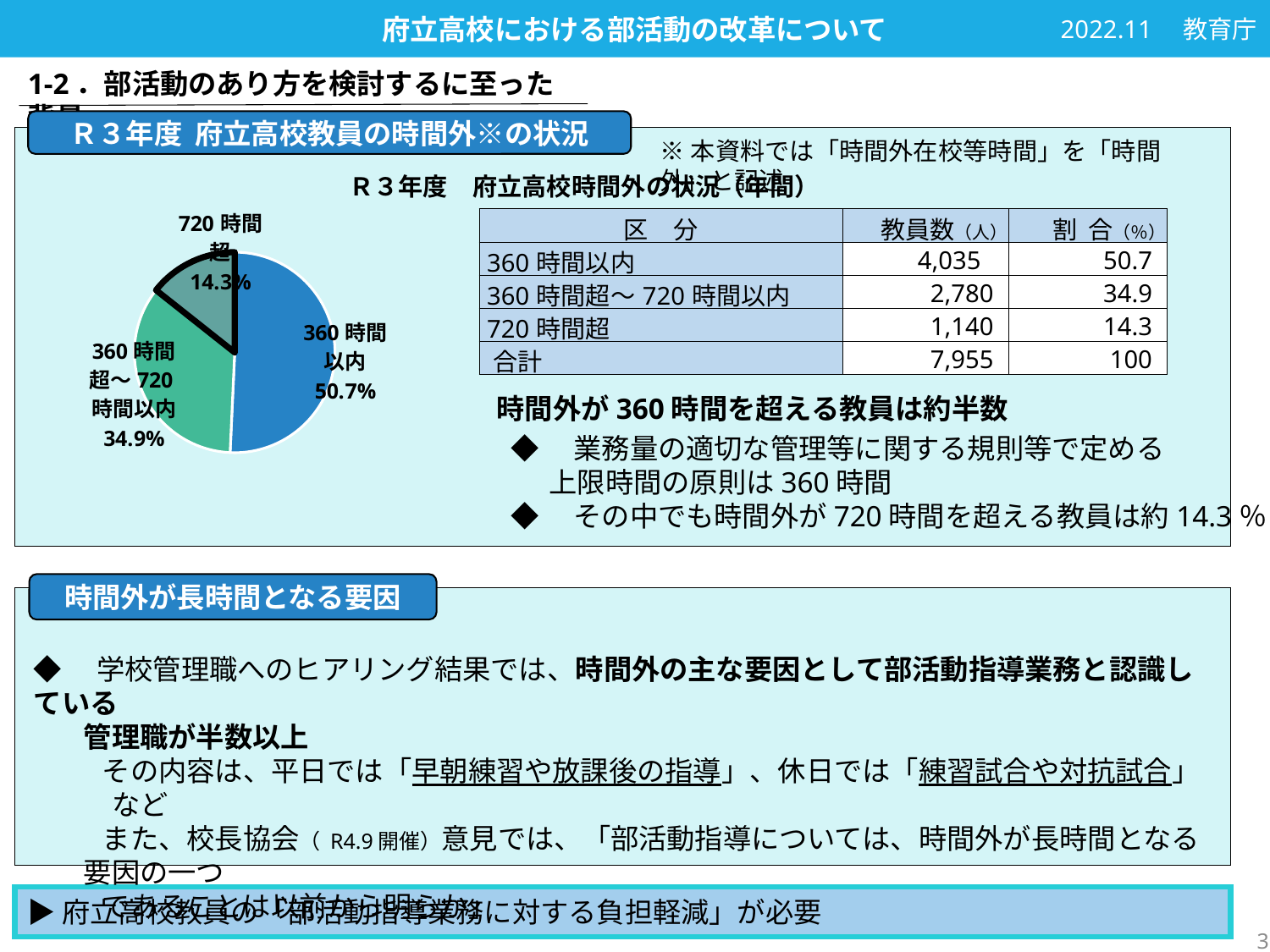
What share of the pie does the 720時間超 slice represent? 14.3% Which slice of the pie chart is the largest? 360時間以内 What share of the pie does the 360時間以内 slice represent? 50.7% What share of the pie does the 360時間超～720時間以内 slice represent? 34.9% What kind of chart is shown on the slide? pie chart Which slice of the pie chart is pulled out (exploded) from the rest of the pie? 720時間超 What is the difference in percentage points between the 360時間以内 slice and the 360時間超～720時間以内 slice? 15.8 What is the difference in percentage points between the 360時間超～720時間以内 slice and the 720時間超 slice? 20.6 Which is larger in the pie chart, the 360時間超～720時間以内 slice or the 720時間超 slice? 360時間超～720時間以内 Which slice of the pie chart is the smallest? 720時間超 How many slices does the pie chart have? 3